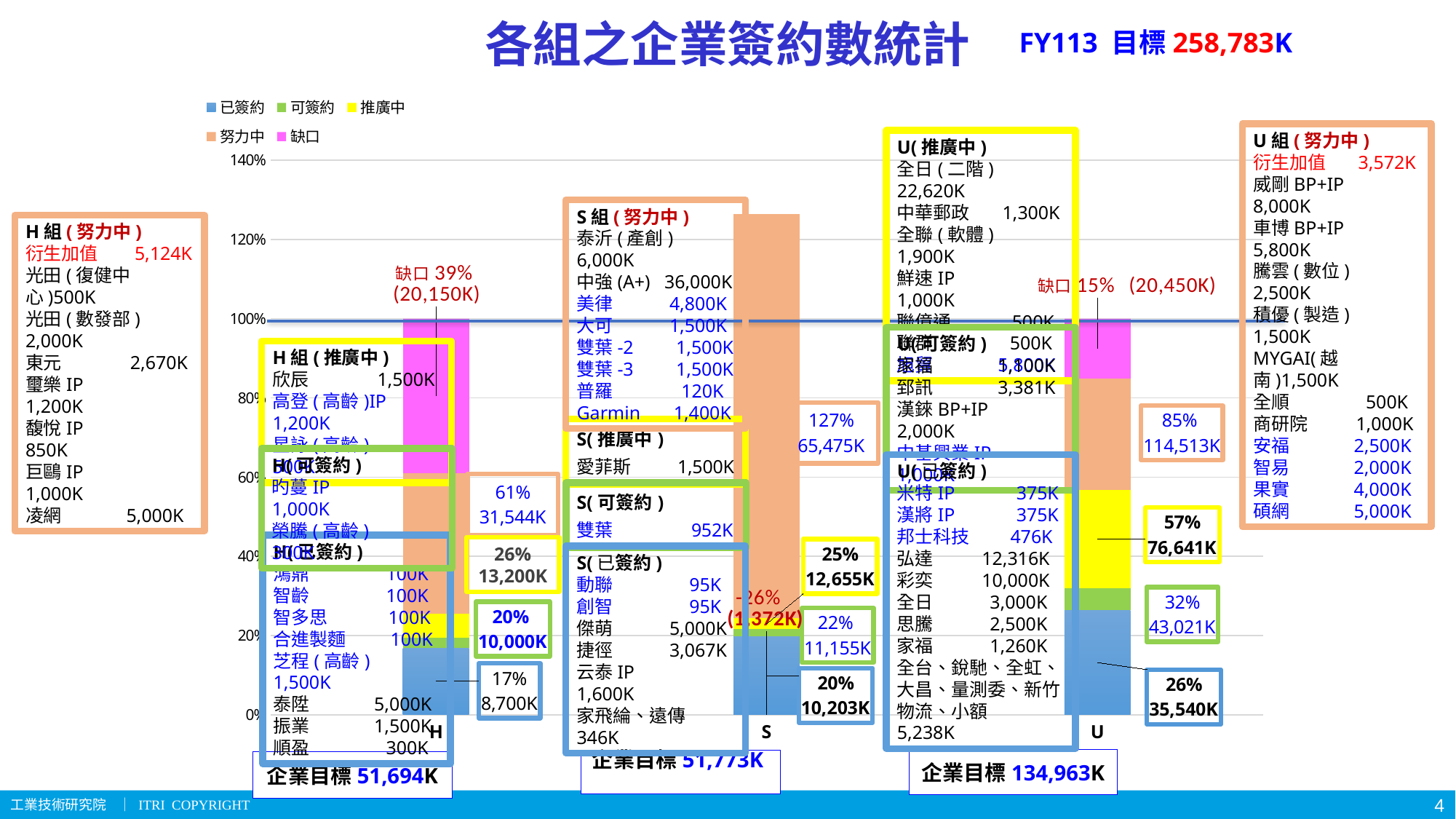
What is the 努力中 value labelled for category S? 127% 65,475K How many categories are shown on the x axis of the chart? 3 Which category has the highest 努力中 percentage? S What is the 推廣中 value labelled for category U? 57% 76,641K Which legend entry is shown in magenta? 缺口 What kind of chart is shown on the slide? stacked bar chart How many series does the chart legend list? 5 Which category has the larger 已簽約 percentage, H or U? U What is the title of the chart? 各組之企業簽約數統計 What is the 可簽約 value labelled for category U? 32% 43,021K What is the 已簽約 value labelled for category H? 17% 8,700K What 缺口 percentage is labelled for category H? 39%